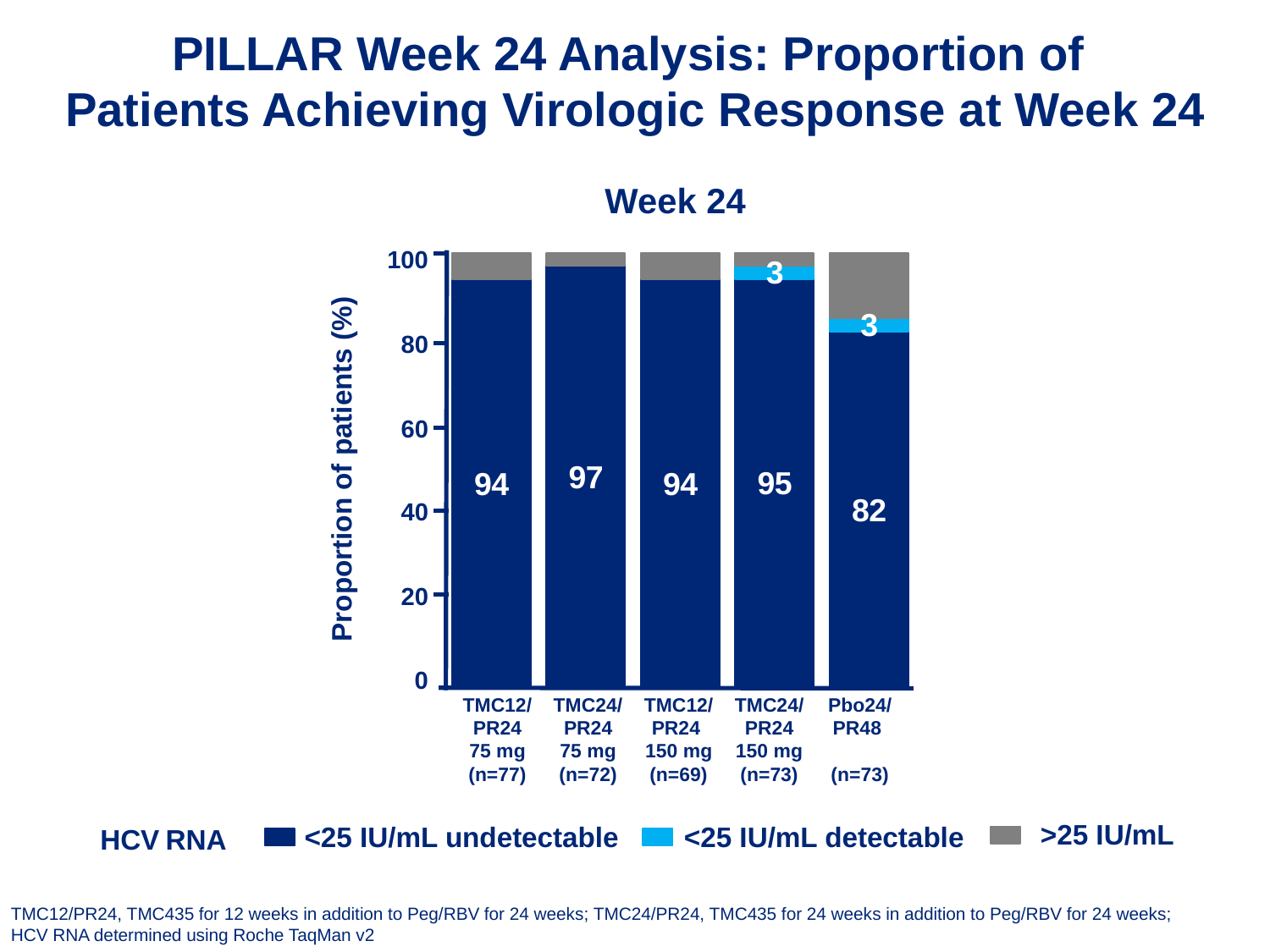
What type of chart is used on this slide? Stacked bar chart Which group has a larger <25 IU/mL undetectable percentage: TMC24/PR24 150 mg or TMC12/PR24 150 mg? TMC24/PR24 150 mg What is the difference in the <25 IU/mL undetectable percentage between the TMC24/PR24 75 mg group and the Pbo24/PR48 group? 15 Is the <25 IU/mL undetectable value for the Pbo24/PR48 group greater or less than 80? greater How many treatment groups are shown on the x axis of the chart? 5 Which treatment group has the highest proportion of patients with HCV RNA <25 IU/mL undetectable? TMC24/PR24 75 mg (n=72) Which treatment group has the lowest proportion of patients with HCV RNA <25 IU/mL undetectable? Pbo24/PR48 (n=73) What percentage of patients in the Pbo24/PR48 (n=73) group had HCV RNA <25 IU/mL undetectable? 82 What is the label of the y axis of the chart? Proportion of patients (%) What percentage of patients in the TMC24/PR24 75 mg (n=72) group had HCV RNA <25 IU/mL undetectable at Week 24? 97 How many HCV RNA categories does the legend list? 3 What is the labelled value for <25 IU/mL detectable in the TMC24/PR24 150 mg (n=73) group? 3